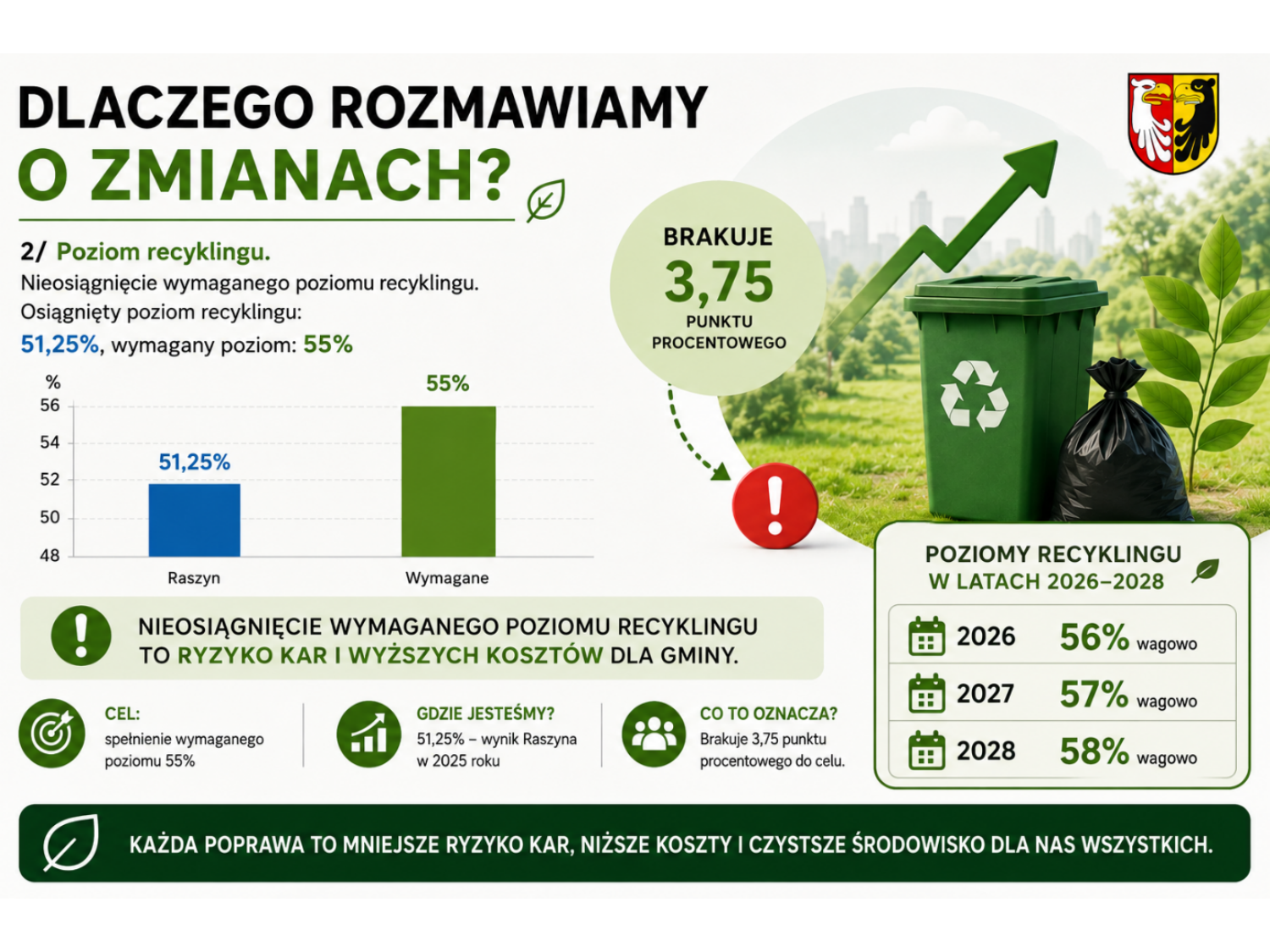
What colour is the Raszyn bar in the chart? blue What kind of chart is shown on the slide? bar chart Which category has the higher value in the bar chart? Wymagane What is the difference between the Wymagane value and the Raszyn value in the bar chart? 3,75 What is the value for Raszyn in the bar chart? 51,25% How many bars are shown in the bar chart? 2 Is the value for Wymagane greater or less than 54? greater Is the value for Raszyn greater or less than 52? less What is the value for Wymagane in the bar chart? 55% Is the value for Raszyn larger or smaller than the value for Wymagane? smaller What is the lowest value shown on the y axis of the bar chart? 48 Which category has the lower value in the bar chart? Raszyn